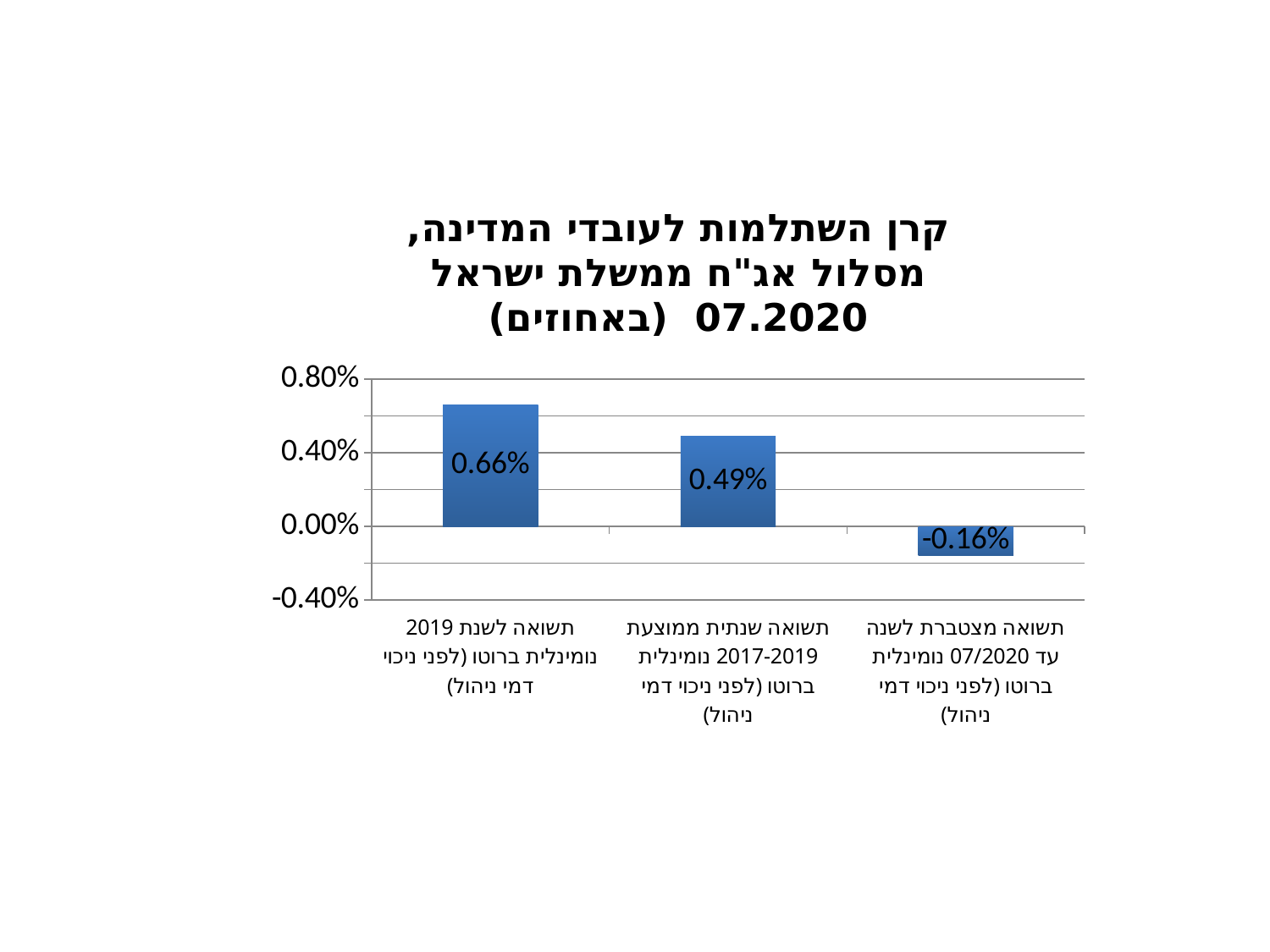
What kind of chart is shown on the slide? Bar chart Which category has the lowest value? תשואה מצטברת לשנה עד 07/2020 נומינלית ברוטו (לפני ניכוי דמי ניהול) What is the value shown for the 2019 nominal gross return (תשואה לשנת 2019 נומינלית ברוטו)? 0.66% Which category has the highest value? תשואה לשנת 2019 נומינלית ברוטו (לפני ניכוי דמי ניהול) What is the value shown for the cumulative return for the year to 07/2020 (תשואה מצטברת לשנה עד 07/2020)? -0.16% Which is larger: the 2019 return or the 2017-2019 average annual return? The 2019 return (0.66%) What is the title of the chart? קרן השתלמות לעובדי המדינה, מסלול אג"ח ממשלת ישראל 07.2020 (באחוזים) Is the value for the cumulative return to 07/2020 greater or less than 0.00%? less What is the value shown for the average annual nominal gross return 2017-2019 (תשואה שנתית ממוצעת 2017-2019)? 0.49% Do the values rise or fall moving from left to right across the categories? Fall What is the difference between the 2019 return (0.66%) and the 2017-2019 average annual return (0.49%)? 0.17% How many categories (bars) are shown in the chart? 3